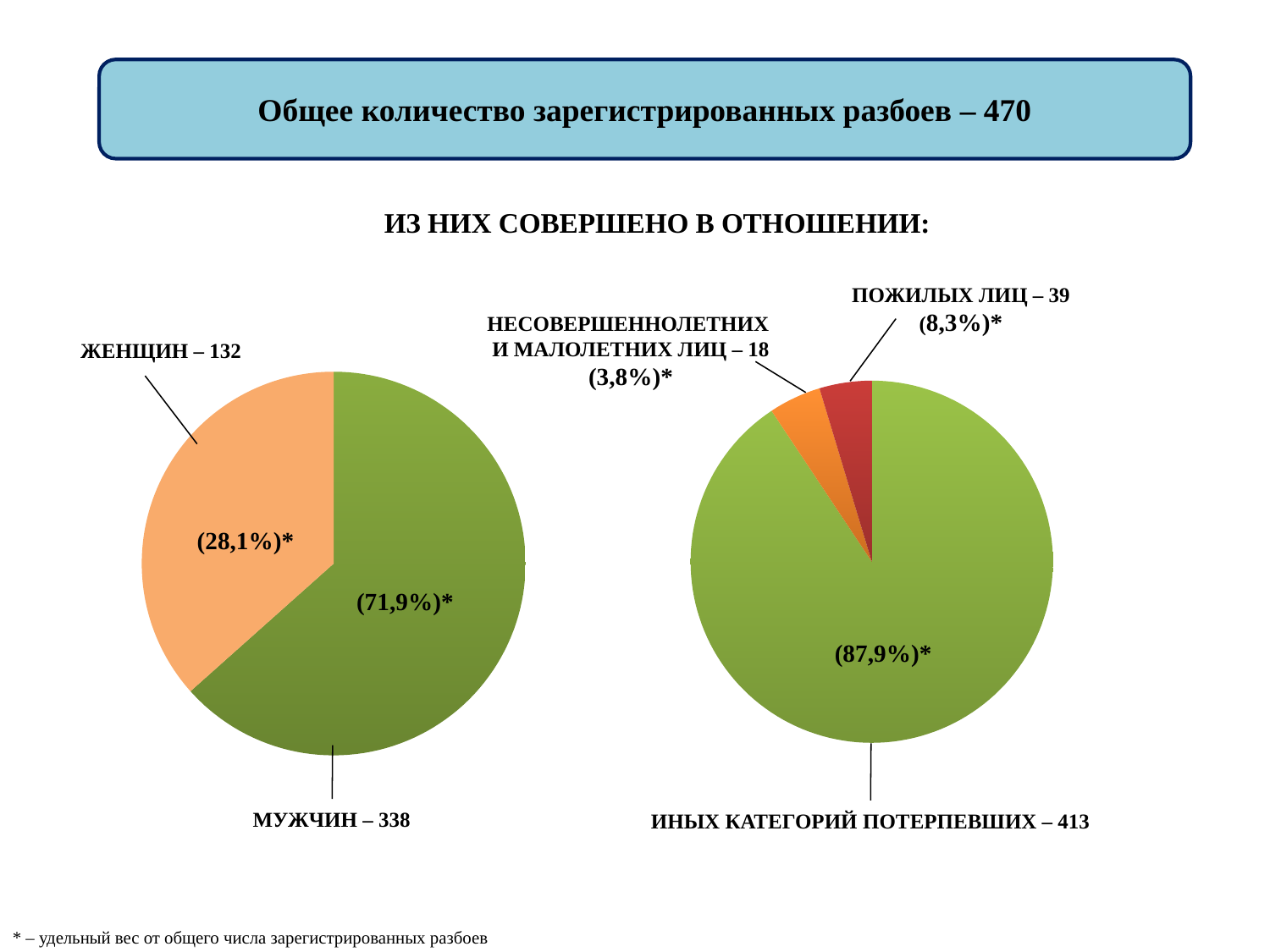
On the right pie chart, which category has the smallest slice? НЕСОВЕРШЕННОЛЕТНИХ И МАЛОЛЕТНИХ ЛИЦ On the left pie chart, what is the value for ЖЕНЩИН? 132 On the right pie chart, what is the value for НЕСОВЕРШЕННОЛЕТНИХ И МАЛОЛЕТНИХ ЛИЦ? 18 On the left pie chart, what is the value for МУЖЧИН? 338 On the left pie chart, what share of the pie does the ЖЕНЩИН slice represent? 28,1% On the right pie chart, which is larger: the value for ПОЖИЛЫХ ЛИЦ or for НЕСОВЕРШЕННОЛЕТНИХ И МАЛОЛЕТНИХ ЛИЦ? ПОЖИЛЫХ ЛИЦ On the right pie chart, what share of the pie does the ИНЫХ КАТЕГОРИЙ ПОТЕРПЕВШИХ slice represent? 87,9% On the right pie chart, what is the value for ПОЖИЛЫХ ЛИЦ? 39 On the left pie chart, what is the difference between the values for МУЖЧИН and ЖЕНЩИН? 206 How many slices does the right pie chart have? 3 On the left pie chart, what share of the pie does the МУЖЧИН slice represent? 71,9% What type of chart is shown on the left of the slide? Pie chart